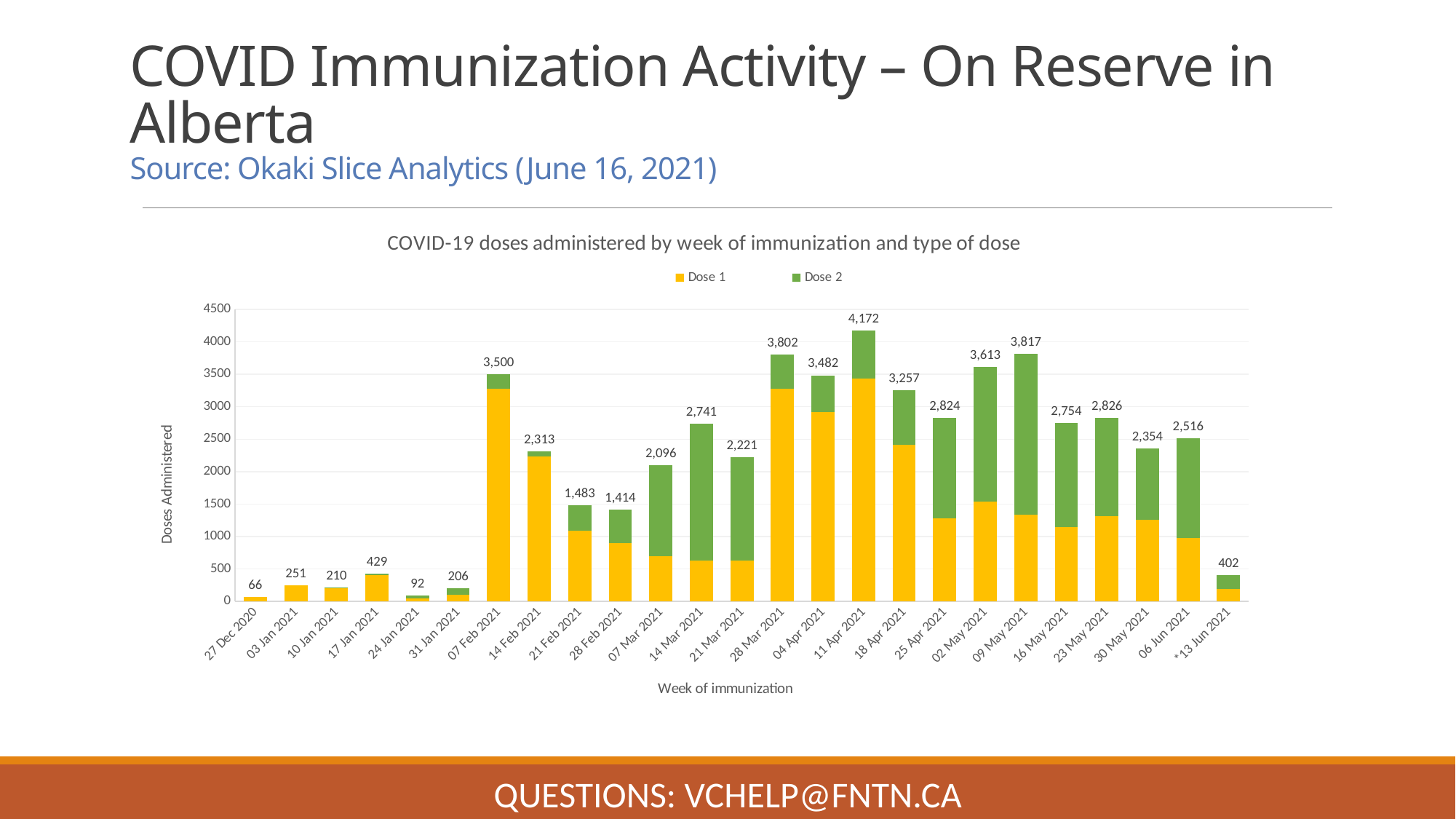
How many series does the legend list? 2 Which week has the lowest total number of doses administered? 27 Dec 2020 Is the Dose 1 value for 07 Feb 2021 greater or less than 3000? greater Is the Dose 1 value for 04 Apr 2021 greater or less than 2500? greater What kind of chart is shown on the slide? Stacked bar chart What is the total number of doses administered in the week of 07 Feb 2021? 3,500 What is the difference between the total doses for 28 Mar 2021 and 04 Apr 2021? 320 How many weeks of immunization are shown on the x axis? 25 What is the total number of doses administered in the week of *13 Jun 2021? 402 Which week has a larger total of doses administered, 14 Mar 2021 or 21 Mar 2021? 14 Mar 2021 Which week has the highest total number of doses administered? 11 Apr 2021 What is the total number of doses administered in the week of 11 Apr 2021? 4,172